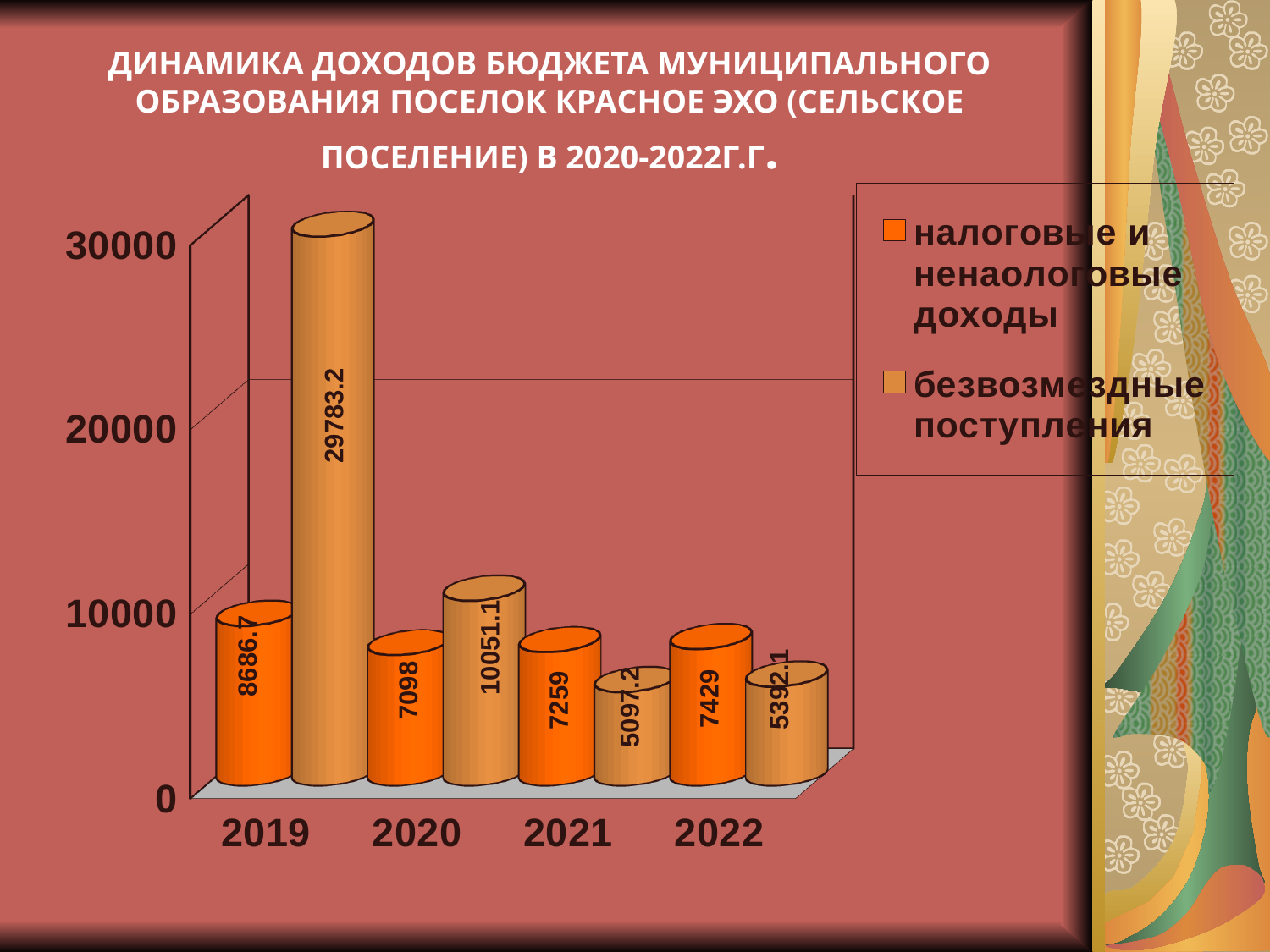
In 2020, which series has the larger value: налоговые и ненаологовые доходы or безвозмездные поступления? безвозмездные поступления In which year were безвозмездные поступления the lowest? 2021 How many years are shown on the x axis? 4 What is the value of налоговые и ненаологовые доходы in 2020? 7098 What is the value of безвозмездные поступления in 2020? 10051.1 What is the value of безвозмездные поступления in 2022? 5392.1 In which year were безвозмездные поступления the highest? 2019 Do the values for налоговые и ненаологовые доходы rise or fall from 2020 to 2022? rise What is the value of безвозмездные поступления in 2019? 29783.2 What is the value of налоговые и ненаологовые доходы in 2022? 7429 In 2021, what is the difference between налоговые и ненаологовые доходы and безвозмездные поступления? 2161.8 How many series does the legend list? 2